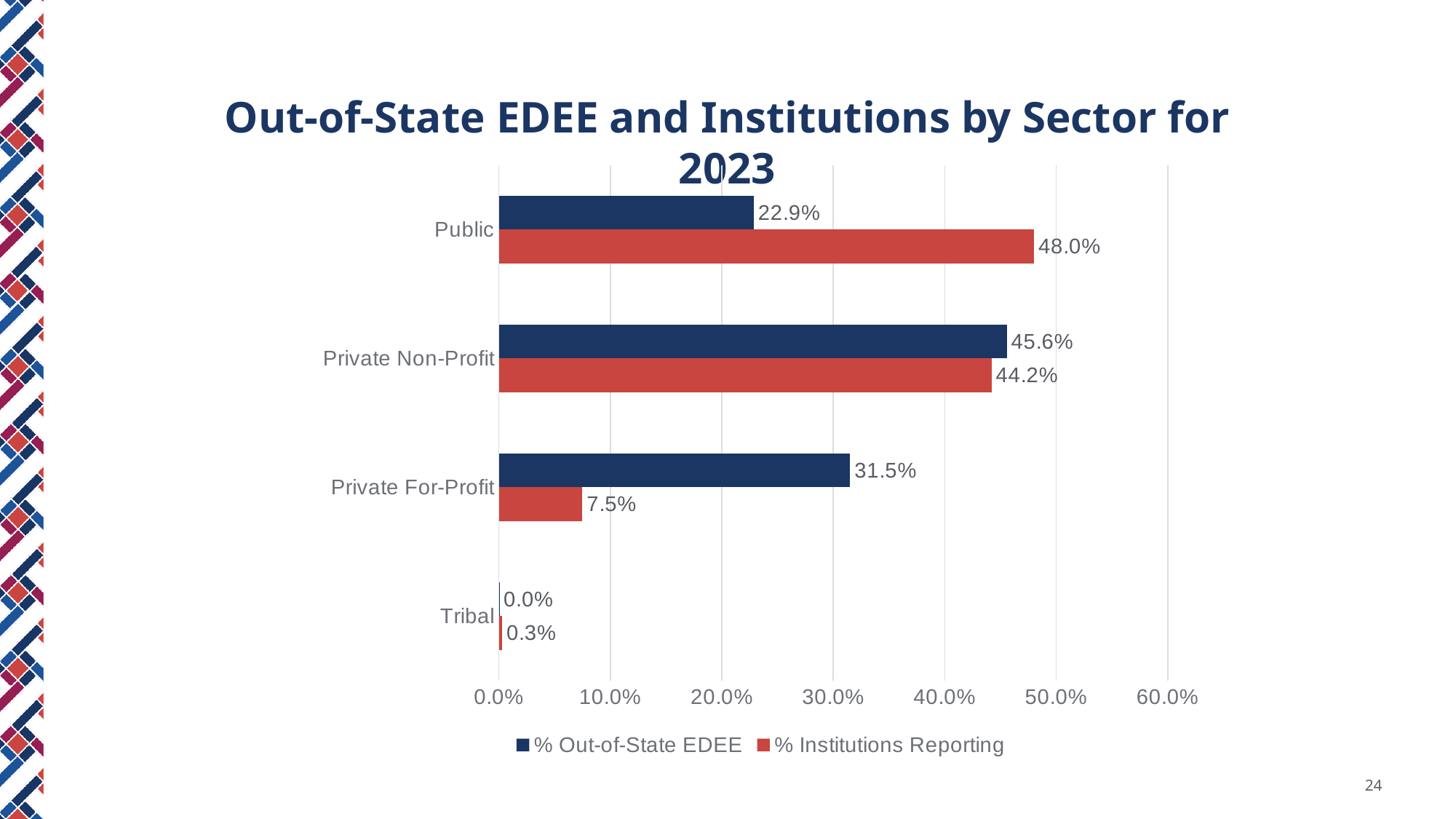
What is the % Institutions Reporting value for Tribal? 0.3% Is the % Out-of-State EDEE value for Private Non-Profit greater or less than 40.0%? greater Which sector has the highest % Institutions Reporting value? Public Which is larger for Private For-Profit: % Out-of-State EDEE or % Institutions Reporting? % Out-of-State EDEE How many series does the legend list? 2 What kind of chart is shown on the slide? Bar chart What is the difference between the % Institutions Reporting and % Out-of-State EDEE values for Public? 25.1% What is the title of the chart? Out-of-State EDEE and Institutions by Sector for 2023 What is the % Institutions Reporting value for Private For-Profit? 7.5% Which sector has the lowest % Out-of-State EDEE value? Tribal What is the % Out-of-State EDEE value for Public? 22.9% How many sectors are shown on the chart? 4